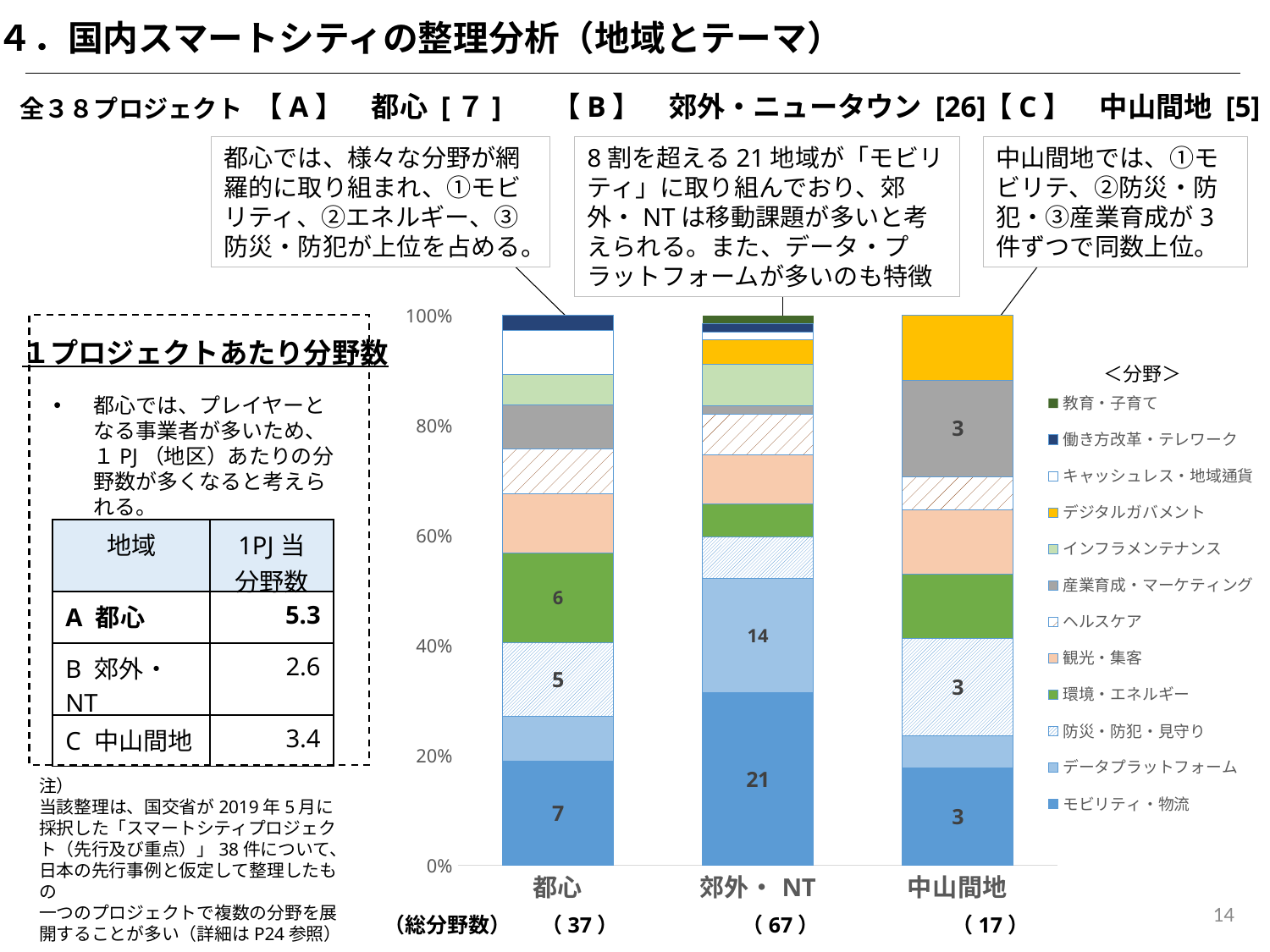
What is the value of the データプラットフォーム segment for 郊外・NT? 14 What is the value of the 防災・防犯・見守り segment for 都心? 5 What is the total number of fields (総分野数) shown for 郊外・NT? 67 What is the difference between the モビリティ・物流 values for 郊外・NT and 都心? 14 What is the value of the モビリティ・物流 segment for 都心? 7 What is the value of the 環境・エネルギー segment for 都心? 6 How many regions (categories) are shown on the x axis of the chart? 3 Which has a larger モビリティ・物流 value, 都心 or 中山間地? 都心 How many series does the legend list? 12 What is the value of the 産業育成・マーケティング segment for 中山間地? 3 What kind of chart is shown on the slide? Stacked bar chart What is the value of the モビリティ・物流 segment for 郊外・NT? 21